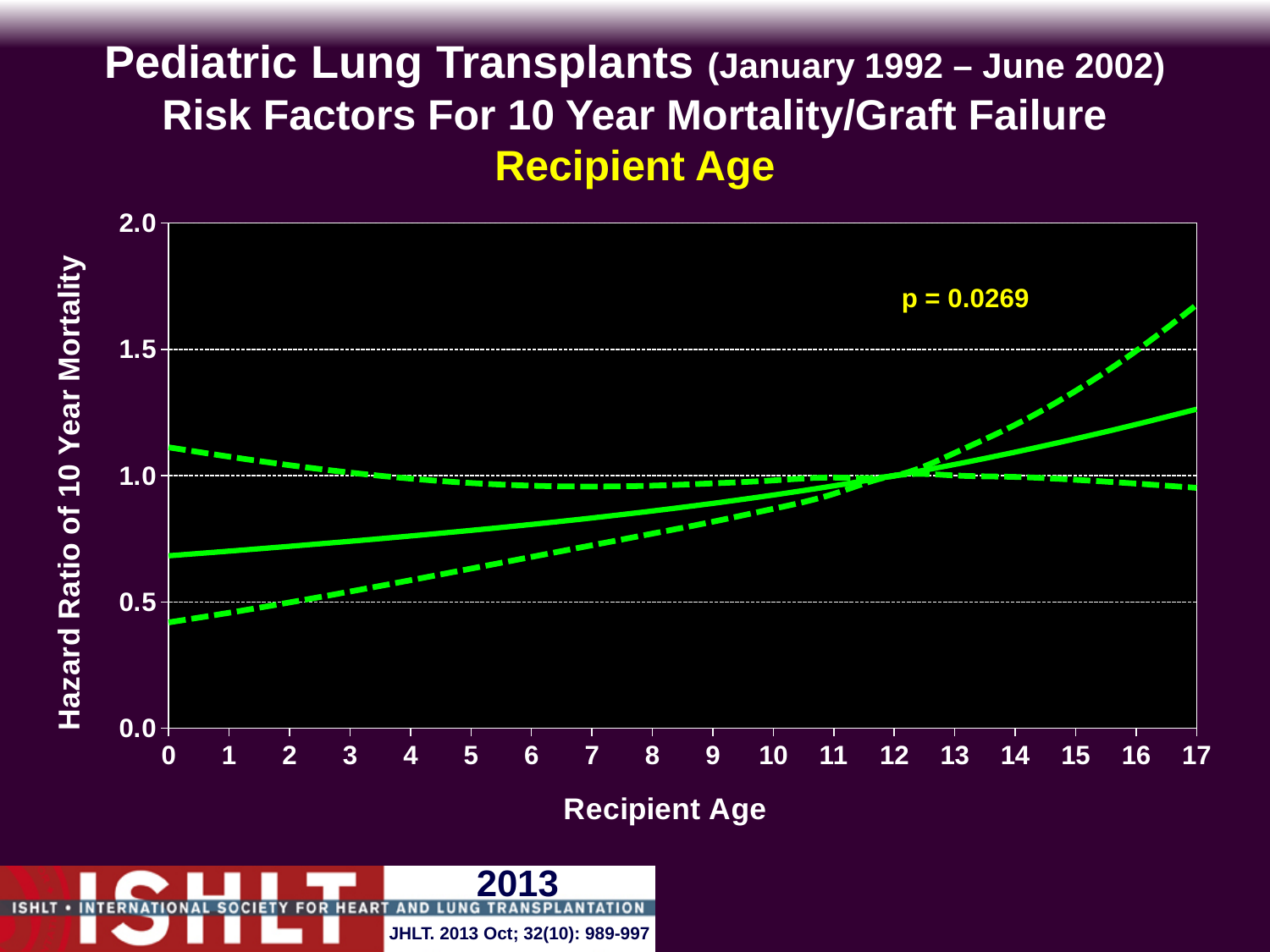
What kind of chart is shown on the slide? line chart How many recipient age tick labels are shown on the x axis? 18 What is the label of the y axis? Hazard Ratio of 10 Year Mortality Is the value of the solid hazard ratio line at recipient age 17 greater or less than 1.0? greater Is the value of the lower dashed line at recipient age 8 greater or less than 0.5? greater Does the solid line for hazard ratio rise or fall as recipient age increases from 0 to 17? rise Is the value of the lower dashed line at recipient age 0 greater or less than 0.5? less What p-value is printed on the chart? p = 0.0269